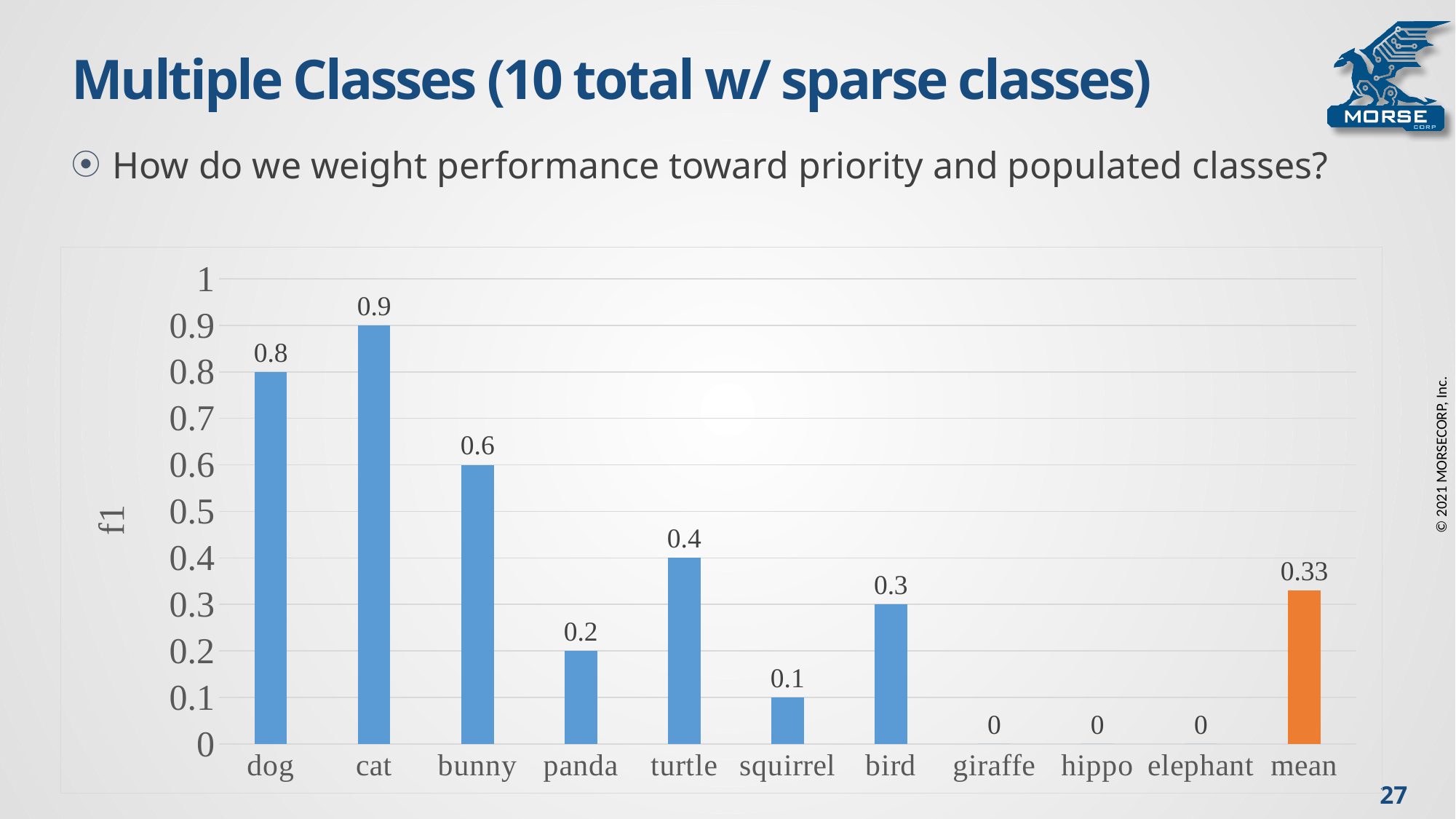
What is the label of the y axis? f1 What is the f1 value for cat? 0.9 What is the value of the mean bar? 0.33 What is the f1 value for squirrel? 0.1 Which bar is shown in orange rather than blue? mean Which class has the highest f1 value? cat What is the difference between the f1 values for dog and bunny? 0.2 What is the f1 value for turtle? 0.4 What kind of chart is shown on the slide? bar chart Which has a higher f1 value, bird or panda? bird How many categories are shown on the x axis, including mean? 11 Which classes have an f1 value of 0? giraffe, hippo, elephant